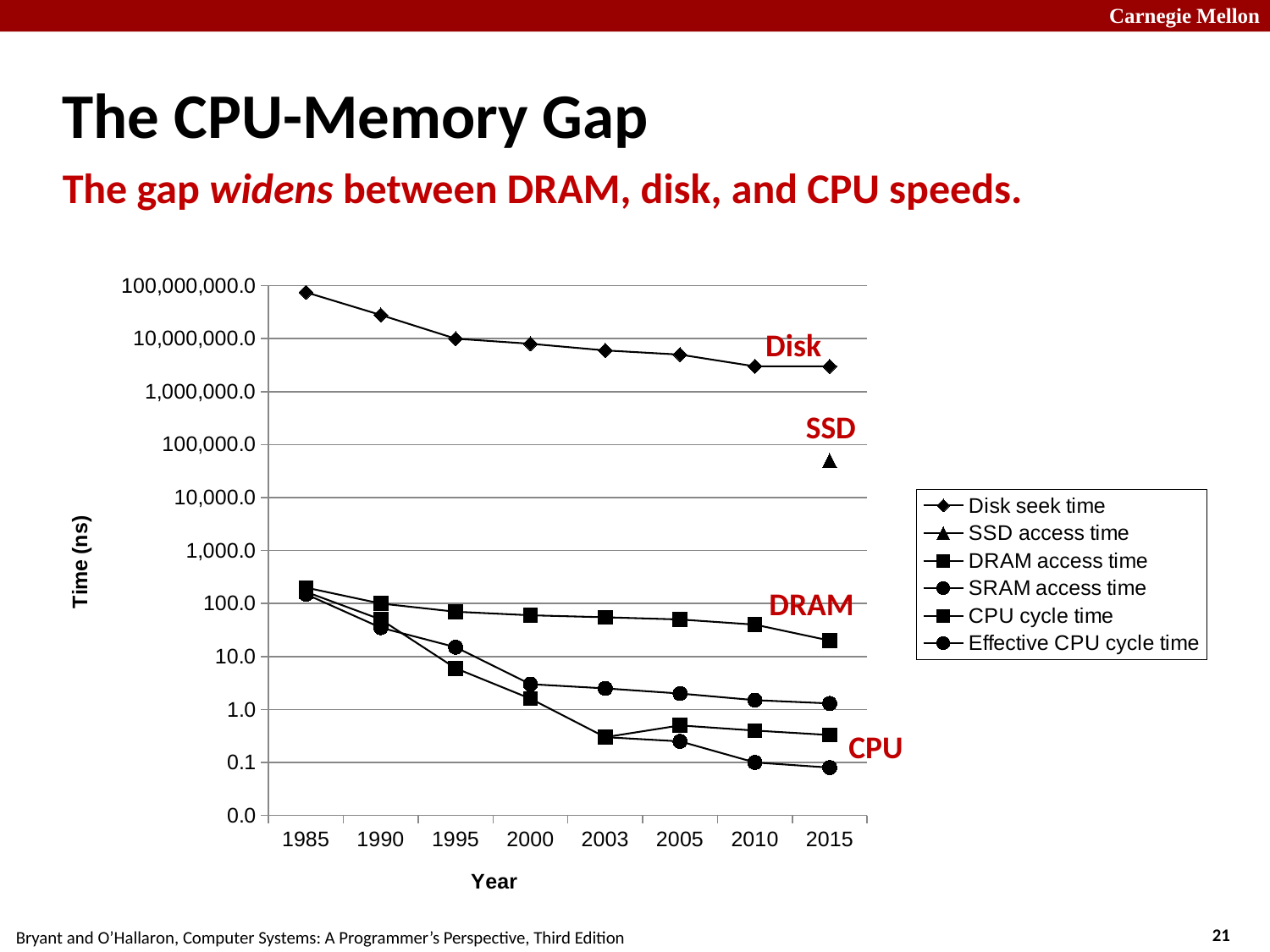
Is the SSD access time in 2015 greater or less than 100,000.0? less How many series does the legend list? 6 Is the Disk seek time in 1985 greater or less than 10,000,000.0? greater Is the DRAM access time in 2015 greater or less than 100.0? less How many years are shown on the x axis? 8 Which series has the lowest value in 2015? Effective CPU cycle time Which series has the highest value in 2015? Disk seek time What is the label of the y axis? Time (ns) In 2000, which is larger: Disk seek time or DRAM access time? Disk seek time Does the Disk seek time rise or fall from 1985 to 2015? fall What kind of chart is shown on the slide? line chart